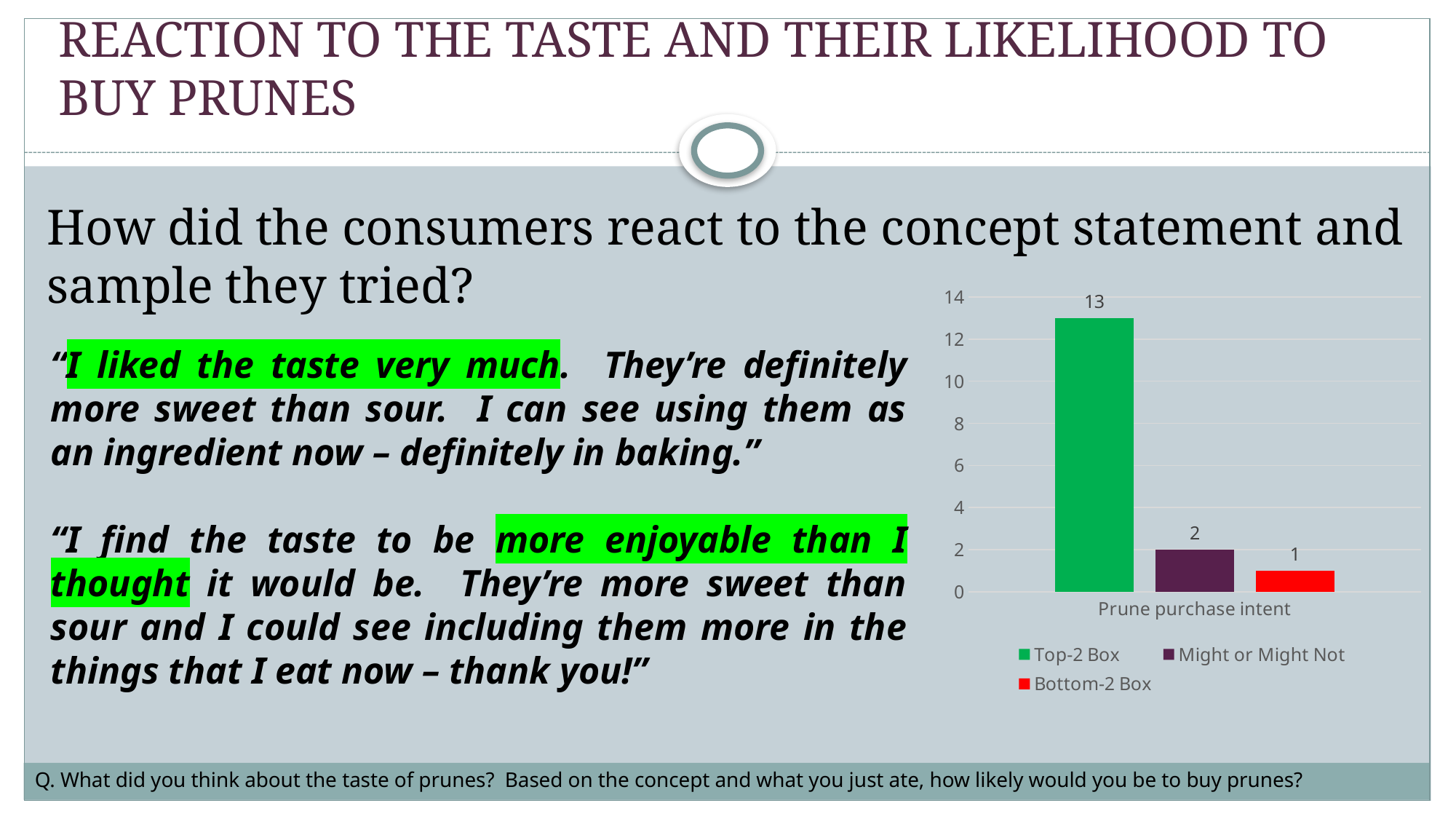
What is the value for Bottom-2 Box in the Prune purchase intent chart? 1 Which series has the highest value in the Prune purchase intent chart? Top-2 Box What is the value for Might or Might Not in the Prune purchase intent chart? 2 Which series has the lowest value in the Prune purchase intent chart? Bottom-2 Box Which is larger, the Top-2 Box value or the Bottom-2 Box value? Top-2 Box Is the value for Top-2 Box greater or less than 10? greater How many series does the legend list in the chart? 3 What is the category label shown on the x axis of the chart? Prune purchase intent What is the value for Top-2 Box in the Prune purchase intent chart? 13 What is the difference between the Might or Might Not and Bottom-2 Box values? 1 What is the difference between the Top-2 Box and Might or Might Not values? 11 What kind of chart is shown on the slide? Bar chart